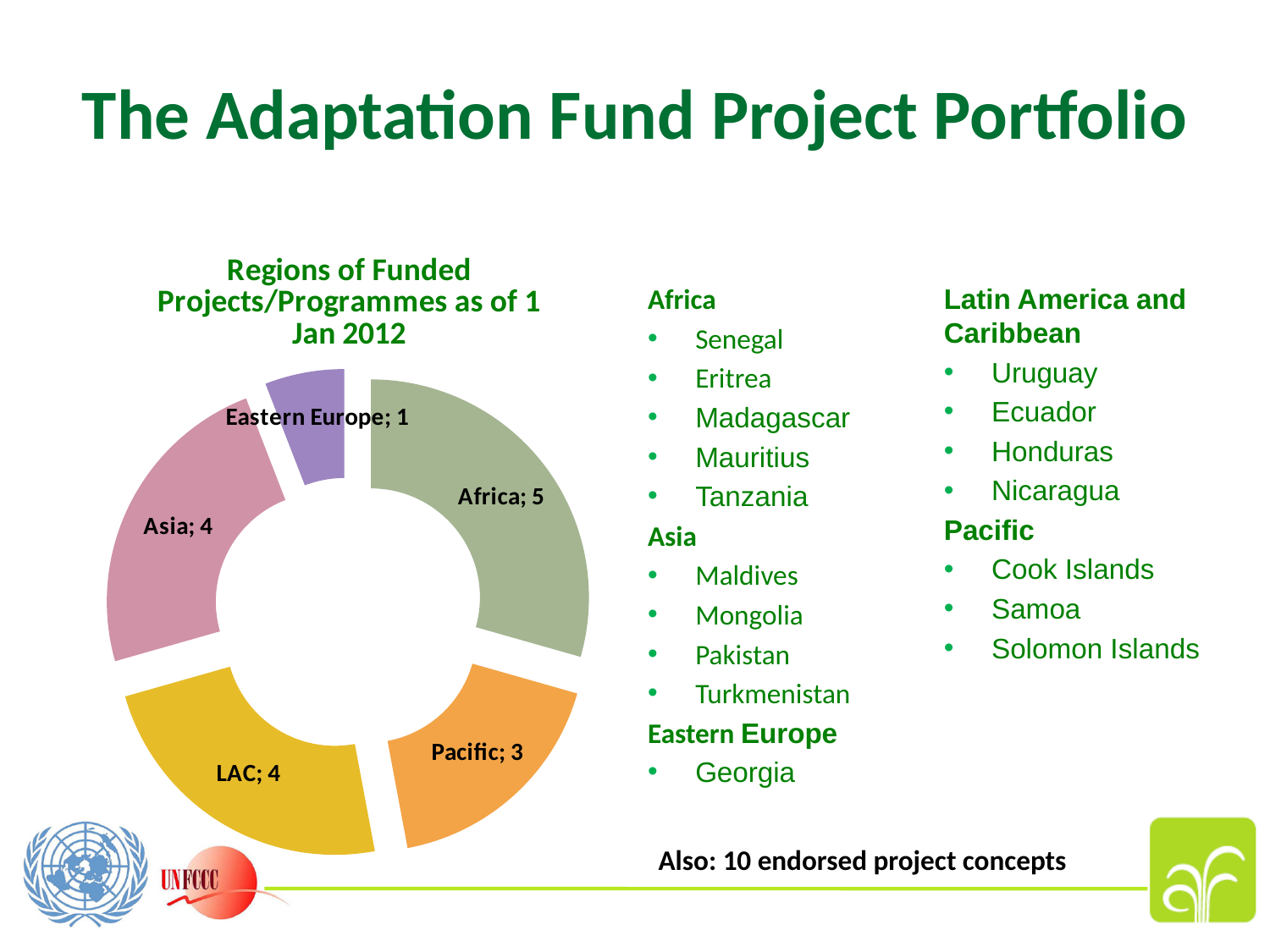
Which region has the highest number of funded projects/programmes in the chart? Africa What is the total number of funded projects/programmes across all regions in the chart? 17 What kind of chart is used to show the regions of funded projects/programmes? Doughnut chart What is the value shown for Pacific in the doughnut chart? 3 Which has a larger value, Asia or Pacific? Asia What is the difference between the values for Africa and Pacific? 2 What is the difference between the values for LAC and Eastern Europe? 3 How many regions are shown in the chart? 5 What is the title of the chart? Regions of Funded Projects/Programmes as of 1 Jan 2012 How many funded projects/programmes does the chart show for Africa? 5 Which region has the lowest number of funded projects/programmes in the chart? Eastern Europe How many projects/programmes are shown for Eastern Europe? 1